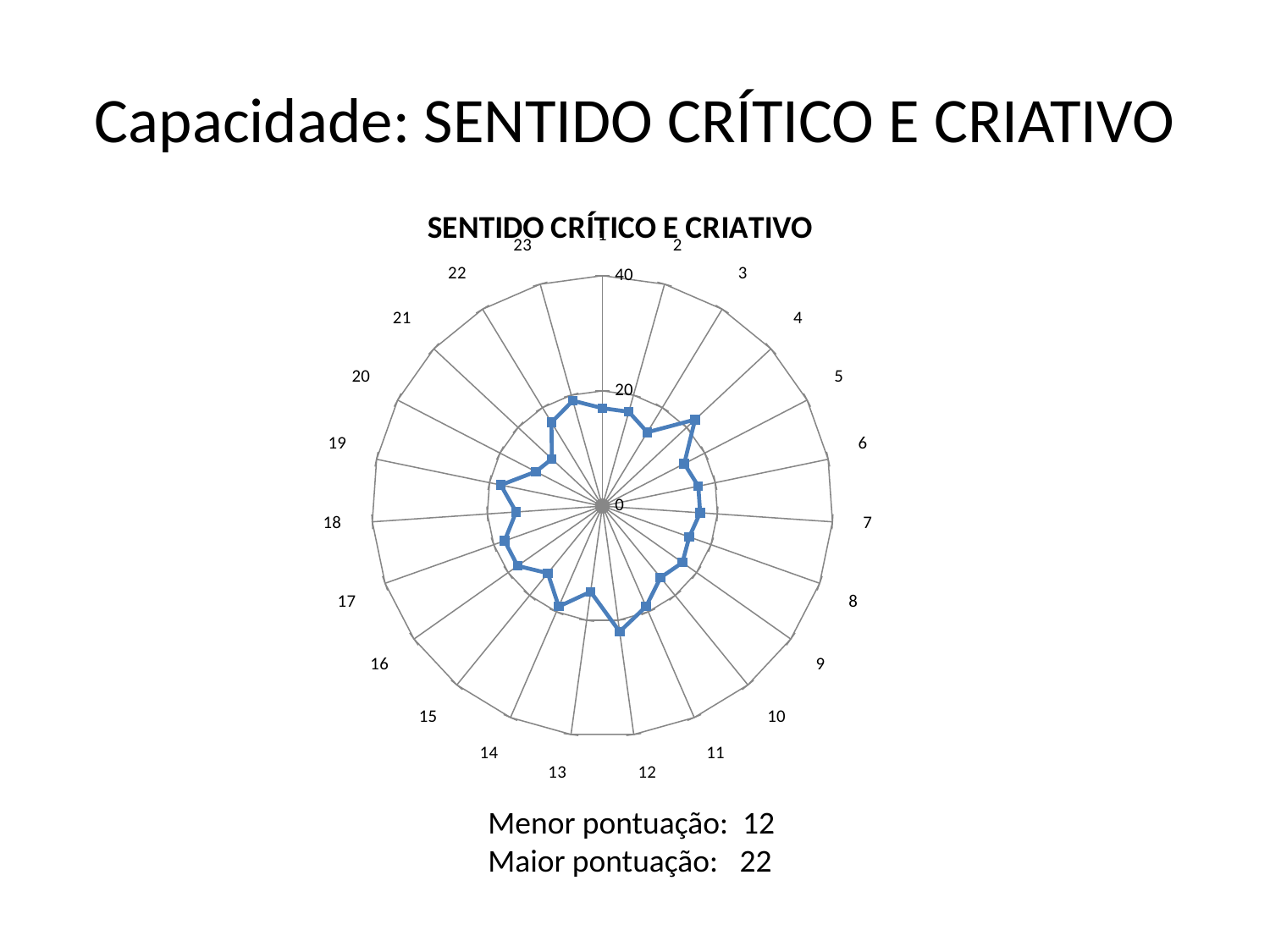
According to the text below the chart, what is the highest score (Maior pontuação)? 22 What is the title of the chart? SENTIDO CRÍTICO E CRIATIVO How many categories (spokes) does the radar chart have? 23 Is the value for category 20 greater or less than 20? less Is the value for category 5 greater or less than 20? less According to the text below the chart, what is the lowest score (Menor pontuação)? 12 What is the highest value shown on the chart's radial axis? 40 What kind of chart is shown on the slide? Radar chart Is the value for category 3 greater or less than 40? less